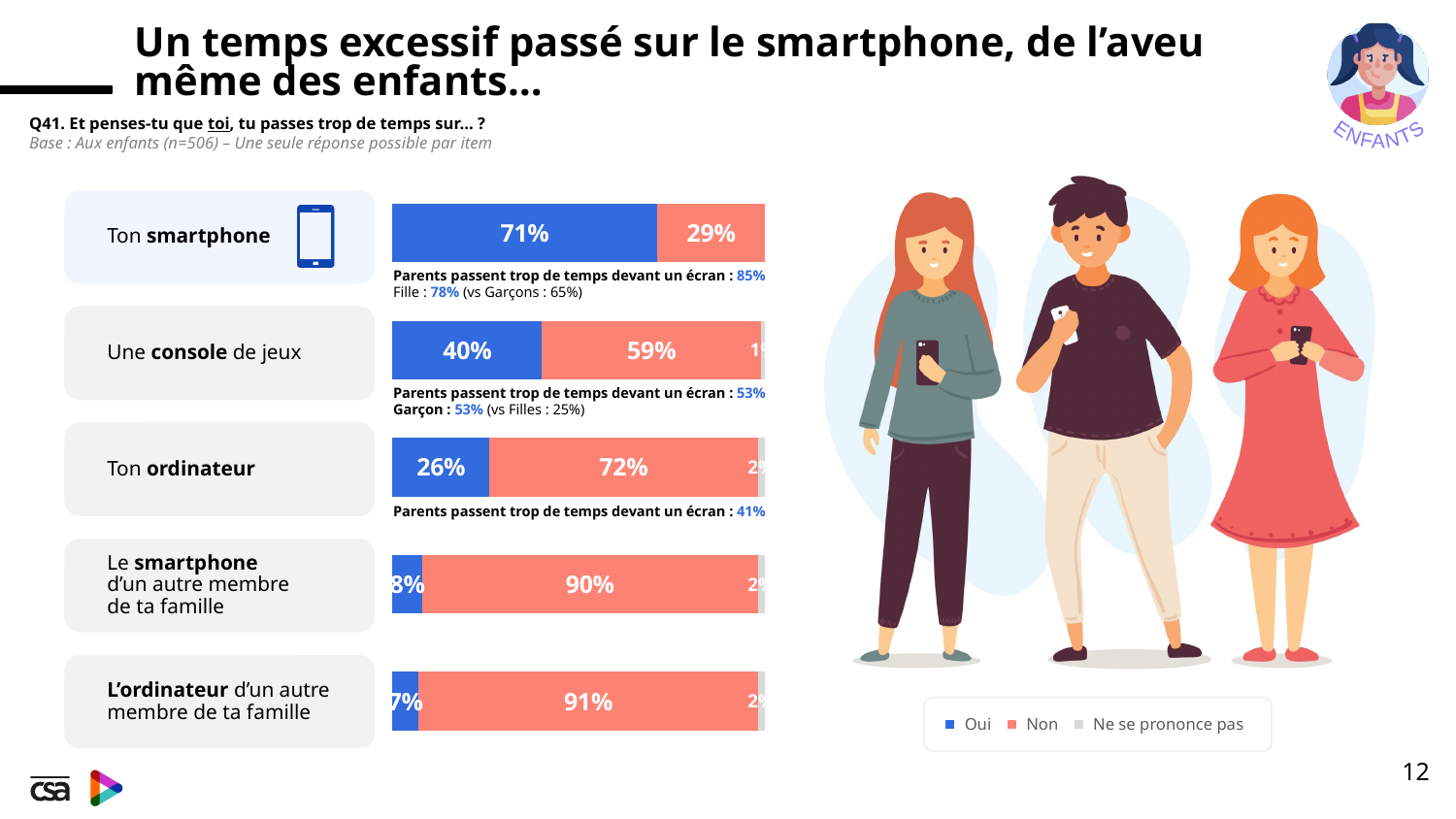
Which item has the lowest "Oui" share? L'ordinateur d'un autre membre de ta famille What is the "Oui" value for "Ton ordinateur"? 26% Is the "Non" share larger for "Ton ordinateur" or for "Le smartphone d'un autre membre de ta famille"? Le smartphone d'un autre membre de ta famille What percentage of children answered "Non" for "Une console de jeux"? 59% How many series does the legend list? 3 Which item has the highest "Oui" share? Ton smartphone What percentage of children answered "Oui" for "Ton smartphone"? 71% What is the difference between the "Oui" values for "Ton smartphone" and "Une console de jeux"? 31 points What type of chart is used on this slide? Stacked bar chart Which colour represents "Non" in the chart? Salmon/red What is the "Non" value for "L'ordinateur d'un autre membre de ta famille"? 91% How many items (categories) are shown in the chart? 5